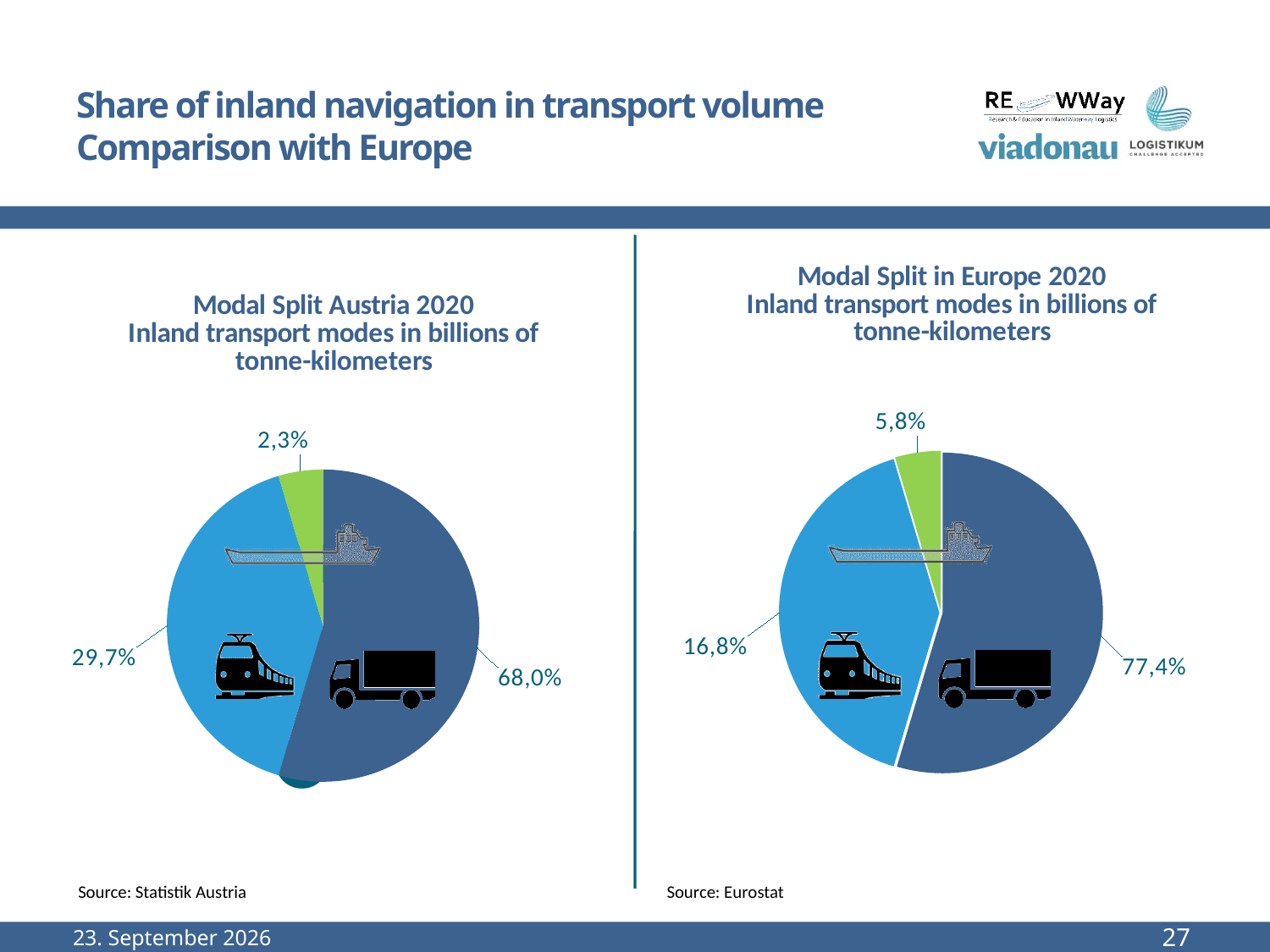
In the Modal Split Austria 2020 chart, what percentage is shown for the slice with the truck icon? 68,0% What source is given for the Modal Split Austria 2020 chart? Statistik Austria In the Modal Split in Europe 2020 chart, what percentage is shown for the green slice with the ship icon? 5,8% In the Modal Split Austria 2020 chart, how many slices does the pie have? 3 In the Modal Split Austria 2020 chart, what percentage is shown for the slice with the train icon? 29,7% In the Modal Split in Europe 2020 chart, which slice is the largest? The slice with the truck icon (77,4%) In the Modal Split Austria 2020 chart, what is the difference between the truck slice and the train slice? 38,3 percentage points In the Modal Split Austria 2020 chart, which slice is the smallest? The green slice with the ship icon (2,3%) Is the ship slice larger in the Modal Split Austria 2020 chart or in the Modal Split in Europe 2020 chart? Modal Split in Europe 2020 (5,8% vs 2,3%) In the Modal Split in Europe 2020 chart, what is the difference between the truck slice and the train slice? 60,6 percentage points What kind of chart is used on the left side of the slide for Modal Split Austria 2020? Pie chart What source is given for the Modal Split in Europe 2020 chart? Eurostat